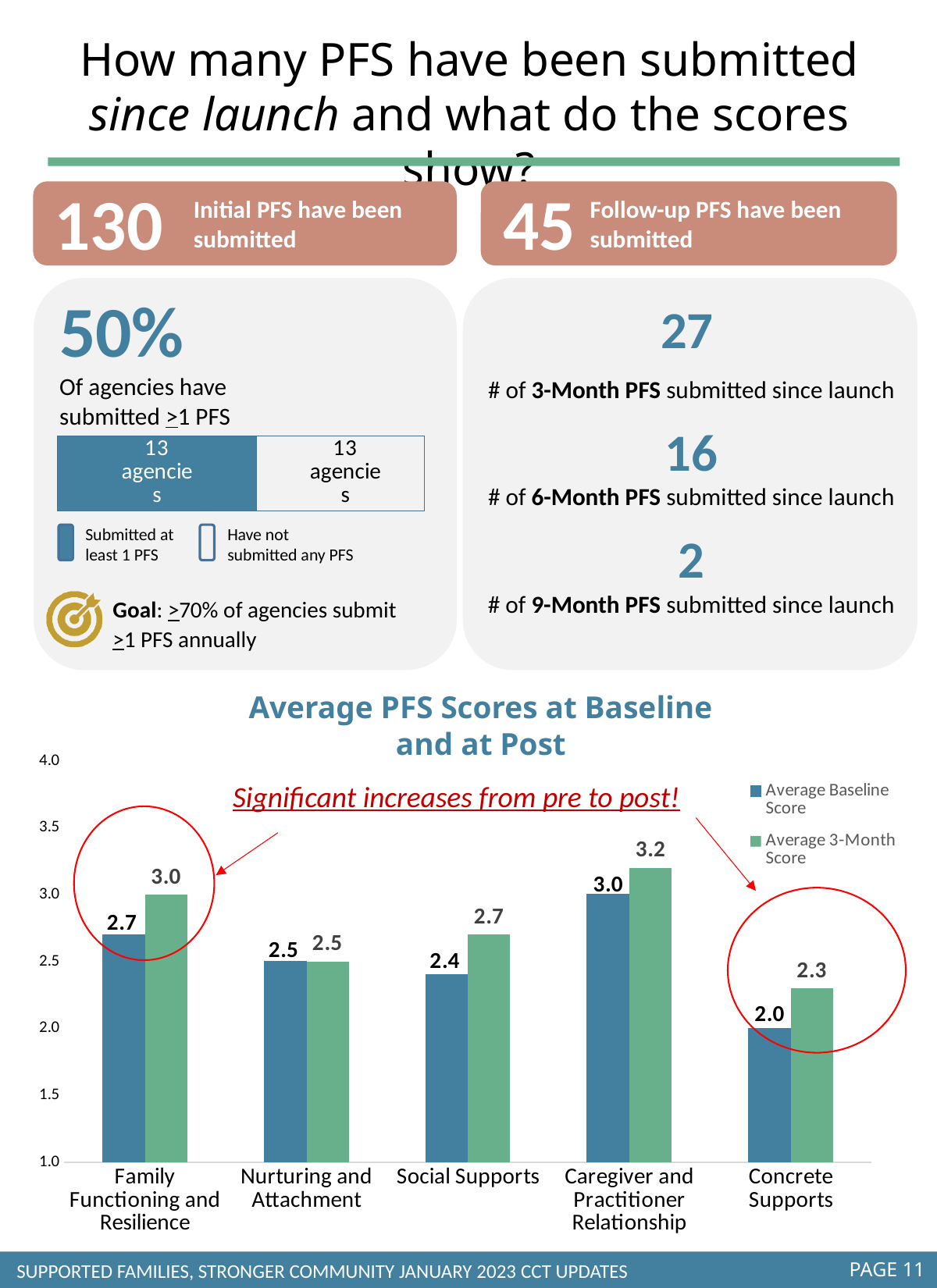
In the chart 'Average PFS Scores at Baseline and at Post', which category has the lowest Average Baseline Score? Concrete Supports In the chart 'Average PFS Scores at Baseline and at Post', how many series does the legend list? 2 In the chart 'Average PFS Scores at Baseline and at Post', how many categories are shown on the x axis? 5 In the chart 'Average PFS Scores at Baseline and at Post', what is the Average 3-Month Score for Concrete Supports? 2.3 In the chart 'Average PFS Scores at Baseline and at Post', for which category are the Average Baseline Score and Average 3-Month Score equal? Nurturing and Attachment In the chart 'Average PFS Scores at Baseline and at Post', what is the difference between the Average 3-Month Score and the Average Baseline Score for Concrete Supports? 0.3 In the chart 'Average PFS Scores at Baseline and at Post', what is the Average Baseline Score for Family Functioning and Resilience? 2.7 In the chart 'Average PFS Scores at Baseline and at Post', which category has the highest Average 3-Month Score? Caregiver and Practitioner Relationship In the chart 'Average PFS Scores at Baseline and at Post', what is the difference between the Average 3-Month Score and the Average Baseline Score for Social Supports? 0.3 In the chart 'Average PFS Scores at Baseline and at Post', is the Average Baseline Score for Caregiver and Practitioner Relationship larger than the Average Baseline Score for Nurturing and Attachment? Yes In the chart 'Average PFS Scores at Baseline and at Post', what is the Average 3-Month Score for Social Supports? 2.7 What kind of chart is 'Average PFS Scores at Baseline and at Post'? Bar chart